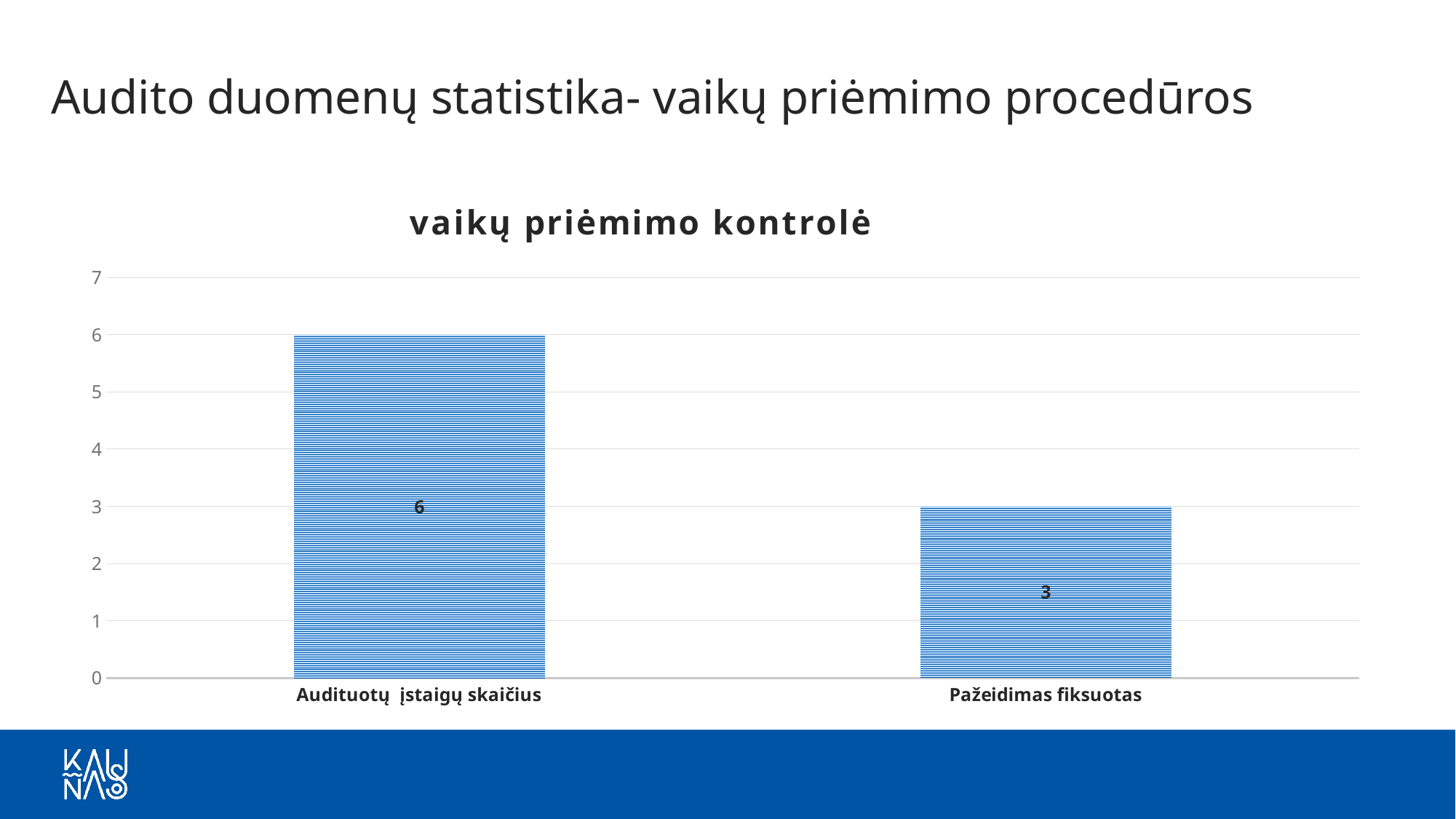
What is the difference between the values for "Audituotų įstaigų skaičius" and "Pažeidimas fiksuotas"? 3 What kind of chart is shown on the slide? bar chart Is the value for "Pažeidimas fiksuotas" greater or less than 5? less Which category has the lowest value? Pažeidimas fiksuotas What is the highest value shown on the vertical axis? 7 Which category has the highest value? Audituotų įstaigų skaičius Which is larger, the value for "Audituotų įstaigų skaičius" or for "Pažeidimas fiksuotas"? Audituotų įstaigų skaičius Do the values rise or fall from left to right along the x axis? fall What is the title of the chart? vaikų priėmimo kontrolė How many categories are shown in the chart? 2 What is the value for "Pažeidimas fiksuotas"? 3 What is the value for "Audituotų įstaigų skaičius"? 6